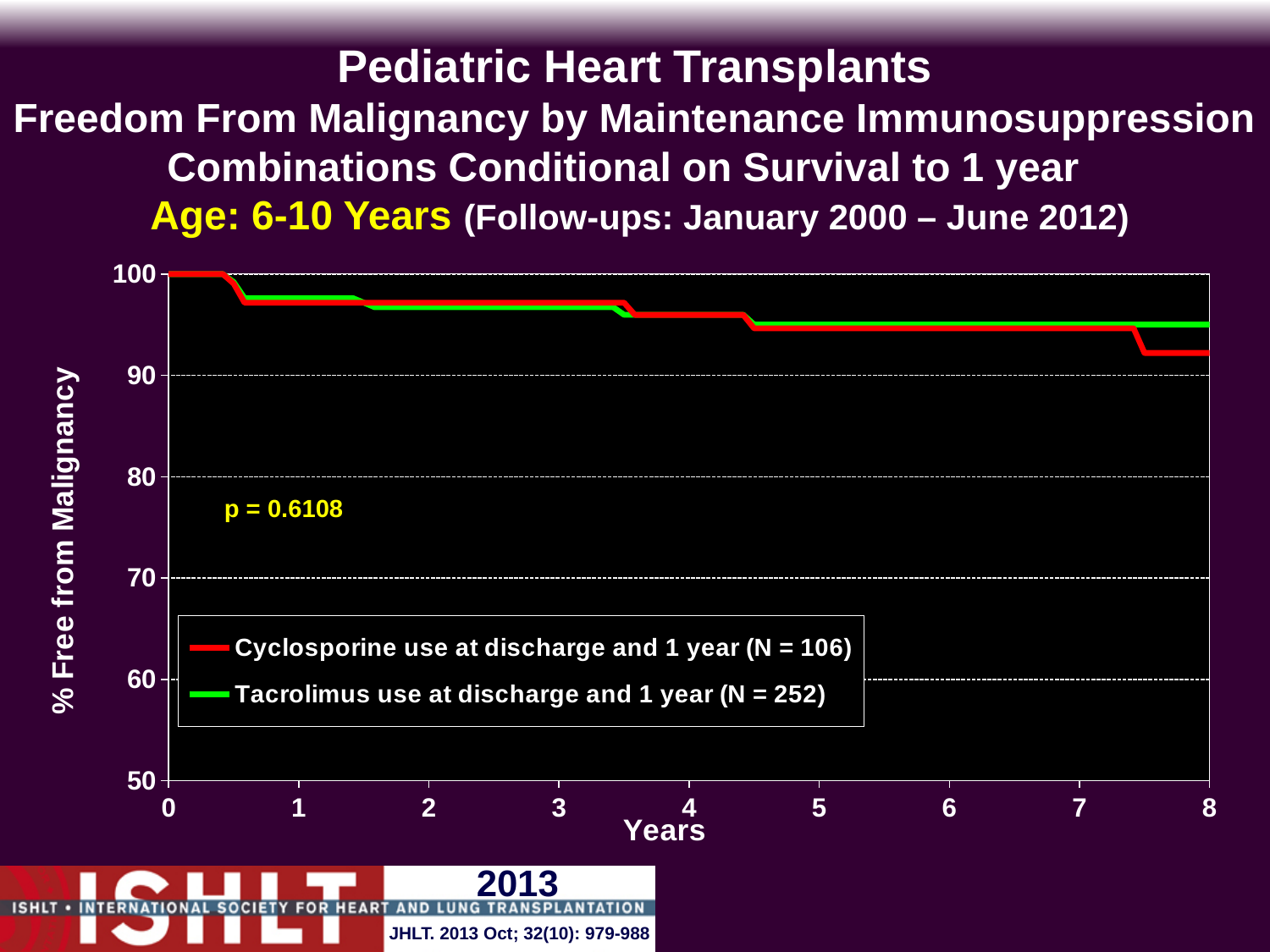
Is the value for Tacrolimus use at discharge and 1 year at 2 years greater or less than 90? greater Is the value for Tacrolimus use at discharge and 1 year at 8 years greater or less than 90? greater How many series does the legend list? 2 Do the plotted values rise or fall as the years increase along the x axis? fall Which series has the lowest value at 8 years? Cyclosporine use at discharge and 1 year At 8 years, which series has the higher % free from malignancy, Cyclosporine or Tacrolimus? Tacrolimus use at discharge and 1 year What is the N for the Cyclosporine use at discharge and 1 year series? N = 106 Is the value for Cyclosporine use at discharge and 1 year at 4 years greater or less than 90? greater What p-value is shown on the chart? p = 0.6108 What kind of chart is shown on the slide? line chart